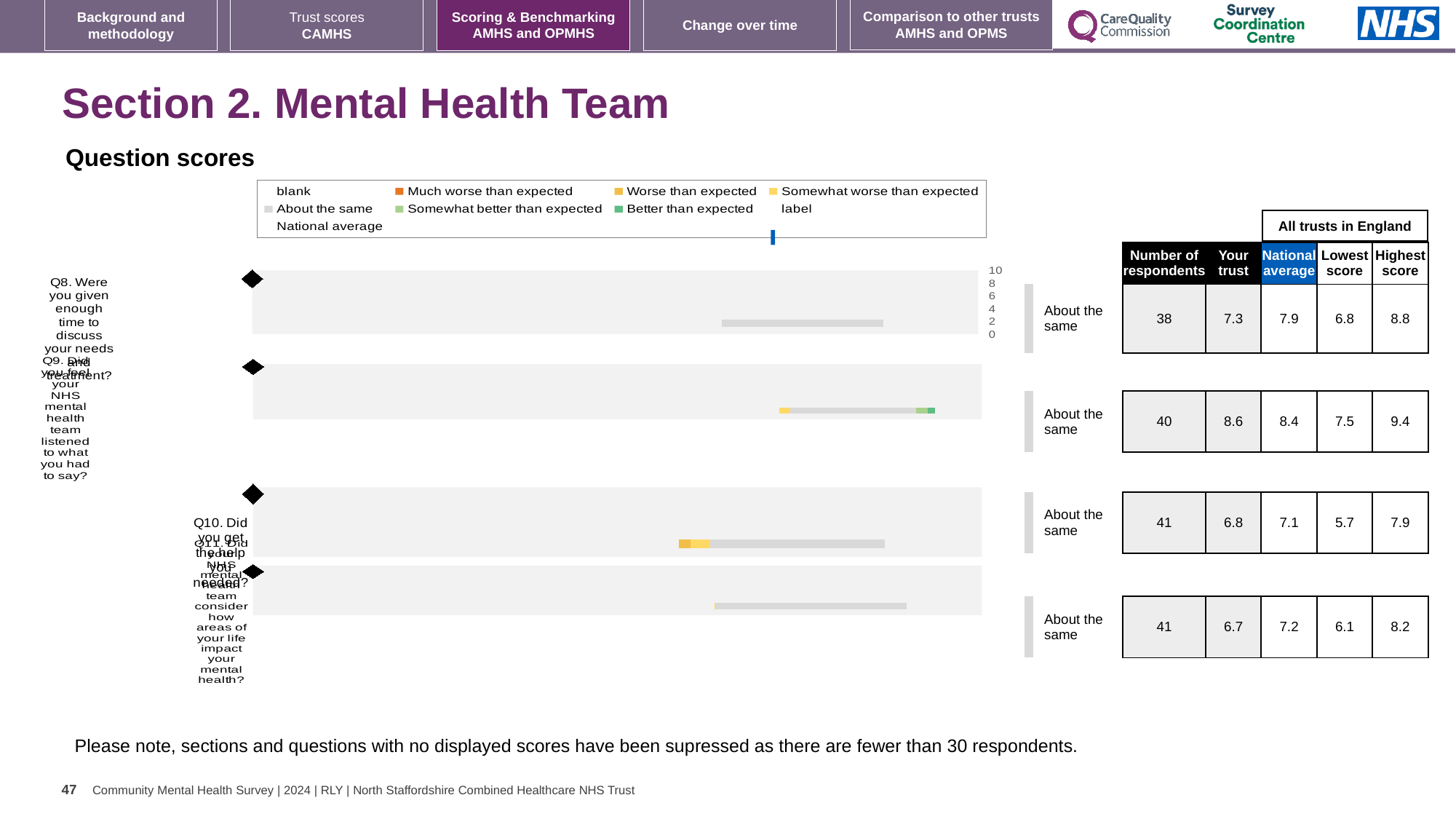
For Q8, is the "Your trust" score higher or lower than the national average? lower For Q9, what is the difference between the highest score and the lowest score across all trusts in England? 1.9 How many questions (Q8 to Q11) have a score chart on the slide? 4 Which question has the lowest "Your trust" score? Q11 What benchmark category is shown for Q11 (Did your NHS mental health team consider how areas of your life impact your mental health?)? About the same Which question has the highest "Your trust" score? Q9 In the chart legend, what colour is the "National average" marker? blue In the chart legend, what colour represents "Much worse than expected"? orange How many respondents are shown for Q8 (Were you given enough time to discuss your needs and treatment?)? 38 What is the national average score for Q10 (Did you get the help you needed?)? 7.1 What is the "Your trust" score for Q9 (Did you feel your NHS mental health team listened to what you had to say?)? 8.6 What kind of chart is used to show the question scores for Q8 to Q11? bar chart